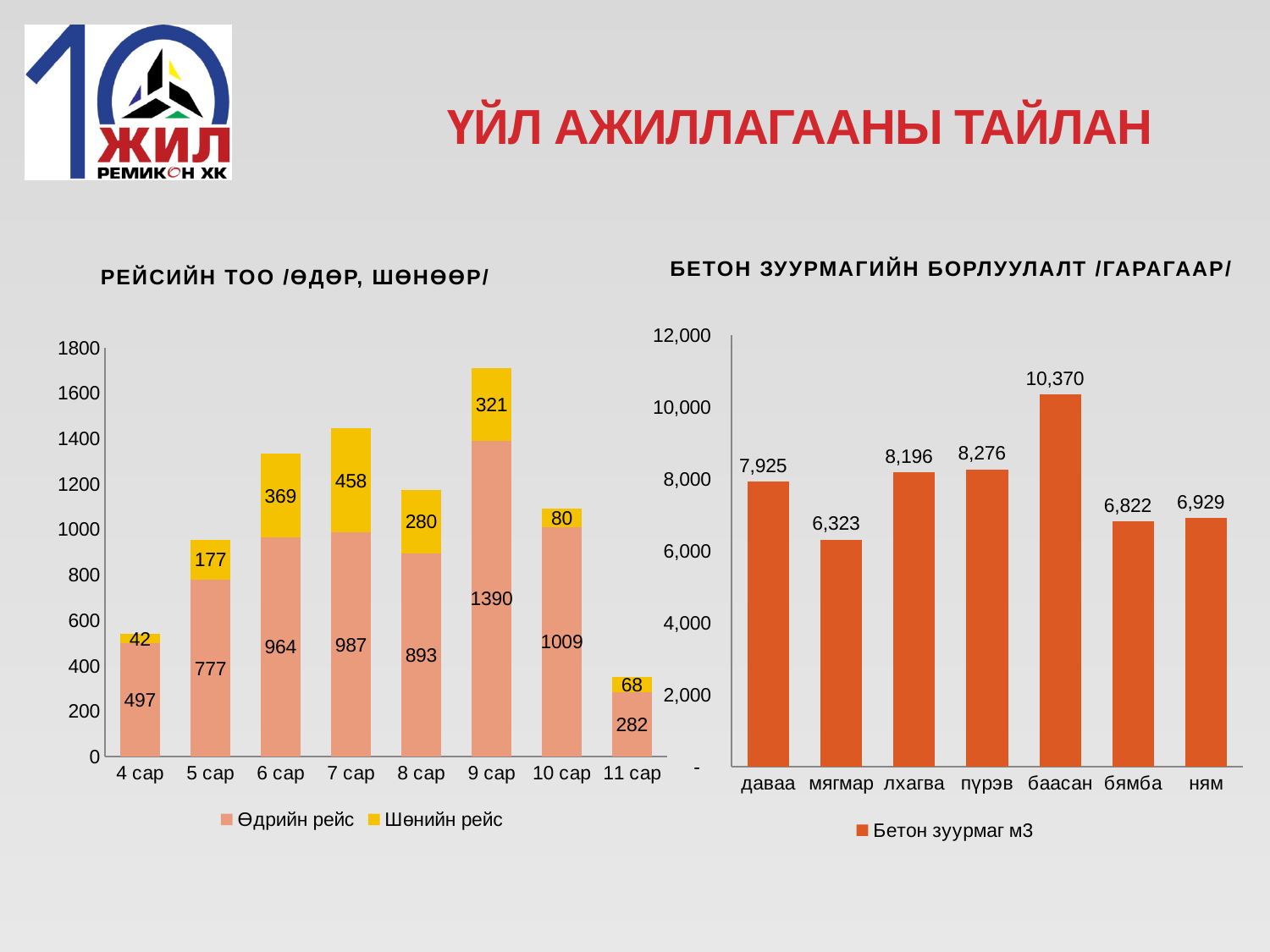
In the chart 'БЕТОН ЗУУРМАГИЙН БОРЛУУЛАЛТ /ГАРАГААР/', which is larger, the value for лхагва or the value for ням? лхагва In the chart 'РЕЙСИЙН ТОО /ӨДӨР, ШӨНӨӨР/', which month has the lowest Өдрийн рейс value? 11 сар In the chart 'БЕТОН ЗУУРМАГИЙН БОРЛУУЛАЛТ /ГАРАГААР/', what is the value for баасан? 10,370 In the chart 'БЕТОН ЗУУРМАГИЙН БОРЛУУЛАЛТ /ГАРАГААР/', what is the difference between the values for пүрэв and даваа? 351 In the chart 'БЕТОН ЗУУРМАГИЙН БОРЛУУЛАЛТ /ГАРАГААР/', which day has the lowest value? мягмар In the chart 'РЕЙСИЙН ТОО /ӨДӨР, ШӨНӨӨР/', what is the value of Шөнийн рейс for 7 сар? 458 In the chart 'РЕЙСИЙН ТОО /ӨДӨР, ШӨНӨӨР/', how many series does the legend list? 2 What kind of chart is 'БЕТОН ЗУУРМАГИЙН БОРЛУУЛАЛТ /ГАРАГААР/'? Bar chart In the chart 'РЕЙСИЙН ТОО /ӨДӨР, ШӨНӨӨР/', how many months are shown on the x axis? 8 In the chart 'РЕЙСИЙН ТОО /ӨДӨР, ШӨНӨӨР/', what is the total of the stacked bar for 6 сар? 1333 In the chart 'РЕЙСИЙН ТОО /ӨДӨР, ШӨНӨӨР/', what is the difference between Өдрийн рейс for 10 сар and 8 сар? 116 In the chart 'РЕЙСИЙН ТОО /ӨДӨР, ШӨНӨӨР/', what is the value of Өдрийн рейс for 9 сар? 1390